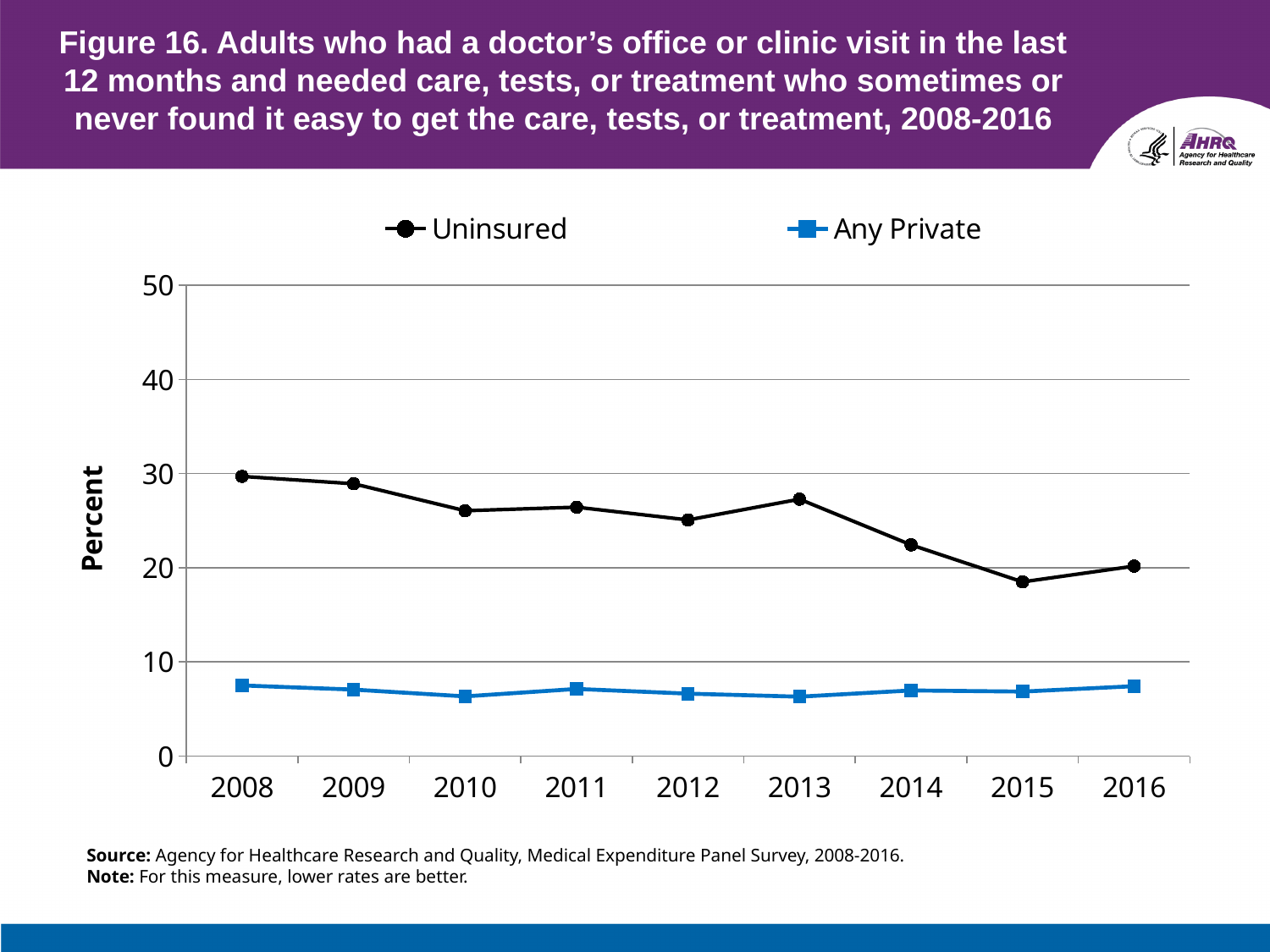
Is the Uninsured value for 2013 greater or less than 30? less In which year is the Uninsured value highest? 2008 In which year is the Uninsured value lowest? 2015 Is the Any Private value for 2008 greater or less than 10? less Is the Uninsured value for 2014 greater or less than 20? greater How many series does the legend list? 2 Which is larger, the Uninsured value for 2008 or for 2016? 2008 Does the Uninsured series overall rise or fall from 2008 to 2016? fall What kind of chart is shown on the slide? line chart How many years are plotted along the x axis? 9 What is the label on the y axis? Percent